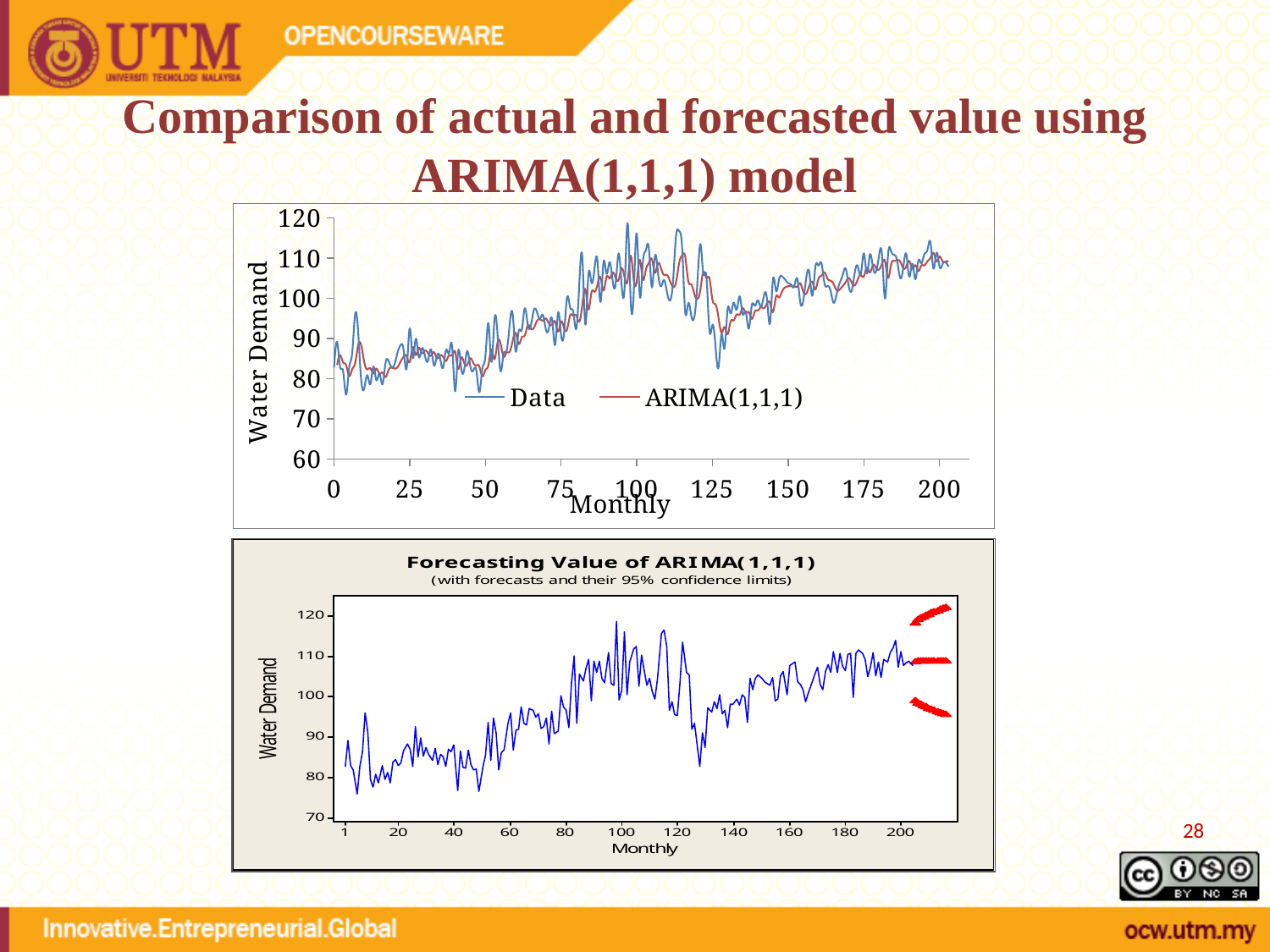
How many series does the legend of the top chart list? 2 What kind of chart is the bottom chart on the slide? line chart In the top chart, is the ARIMA(1,1,1) value at month 50 greater or less than 90? less In the top chart, what is the label of the vertical axis? Water Demand In the bottom chart, is the Water Demand value at month 1 greater or less than 90? less In the top chart, do the Data values overall rise or fall from month 0 to month 200? rise In the bottom chart, do the Water Demand values overall rise or fall from month 1 to month 200? rise What is the title of the bottom chart? Forecasting Value of ARIMA(1,1,1) What are the two series named in the legend of the top chart? Data and ARIMA(1,1,1) In the top chart, is the Data value at month 0 greater or less than 100? less What kind of chart is the top chart on the slide? line chart